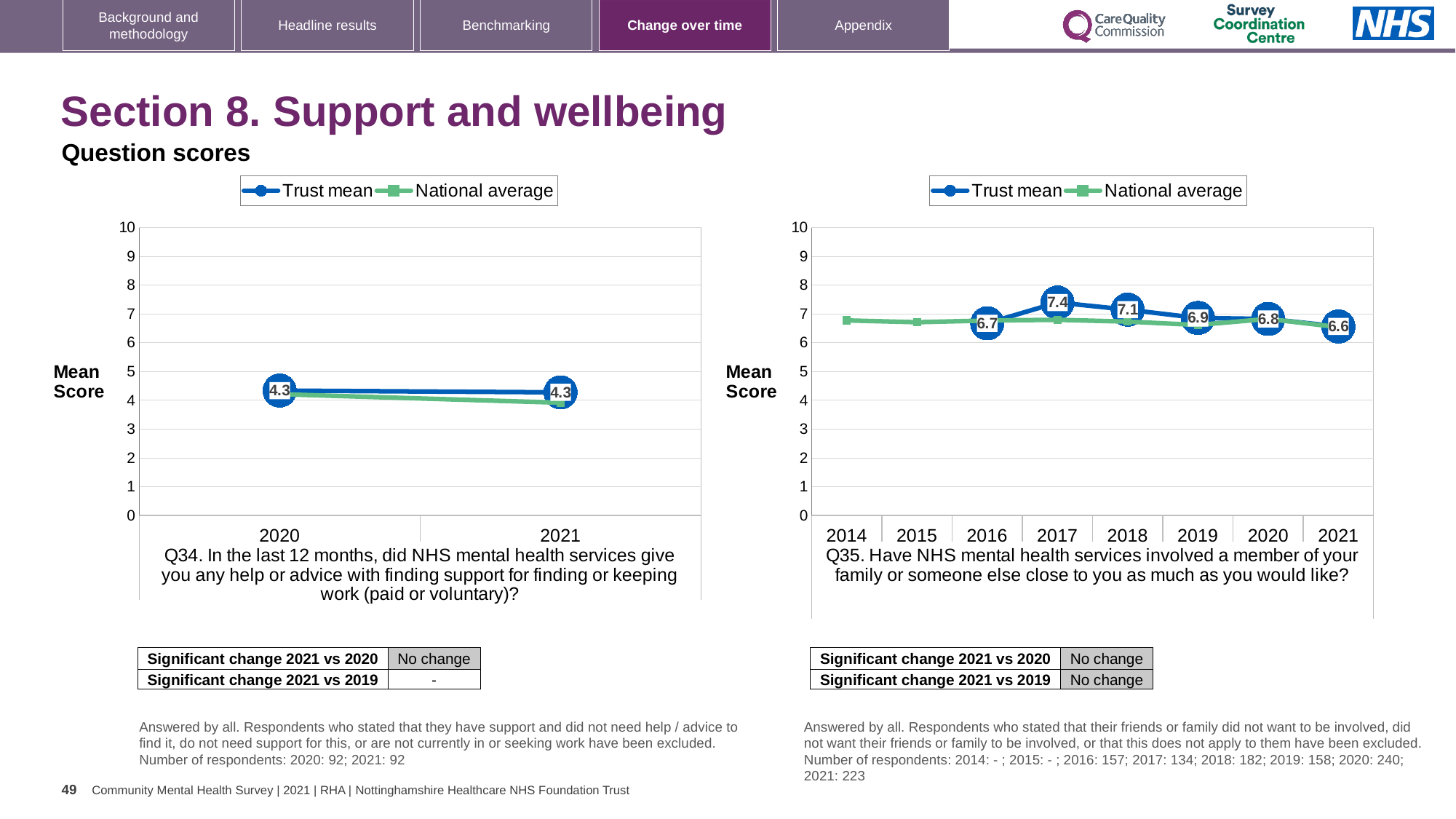
In the Q35 chart on the right, what is the difference between the Trust mean for 2017 and the Trust mean for 2021? 0.8 In the Q35 chart on the right, what is the Trust mean for 2017? 7.4 In the Q35 chart on the right, which year has the highest Trust mean? 2017 In the Q35 chart on the right, is the Trust mean higher in 2018 or in 2020? 2018 How many series does the legend of the Q34 chart on the left list? 2 How many years are shown on the x axis of the Q35 chart on the right? 8 In the Q35 chart on the right, what is the Trust mean for 2021? 6.6 What type of chart is the Q35 chart on the right? Line chart In the Q34 chart on the left, what is the Trust mean for 2020? 4.3 In the Q34 chart on the left, is the National average for 2021 greater or less than 5? less In the Q34 chart on the left, what is the Trust mean for 2021? 4.3 In the Q35 chart on the right, which year has the lowest labelled Trust mean? 2021